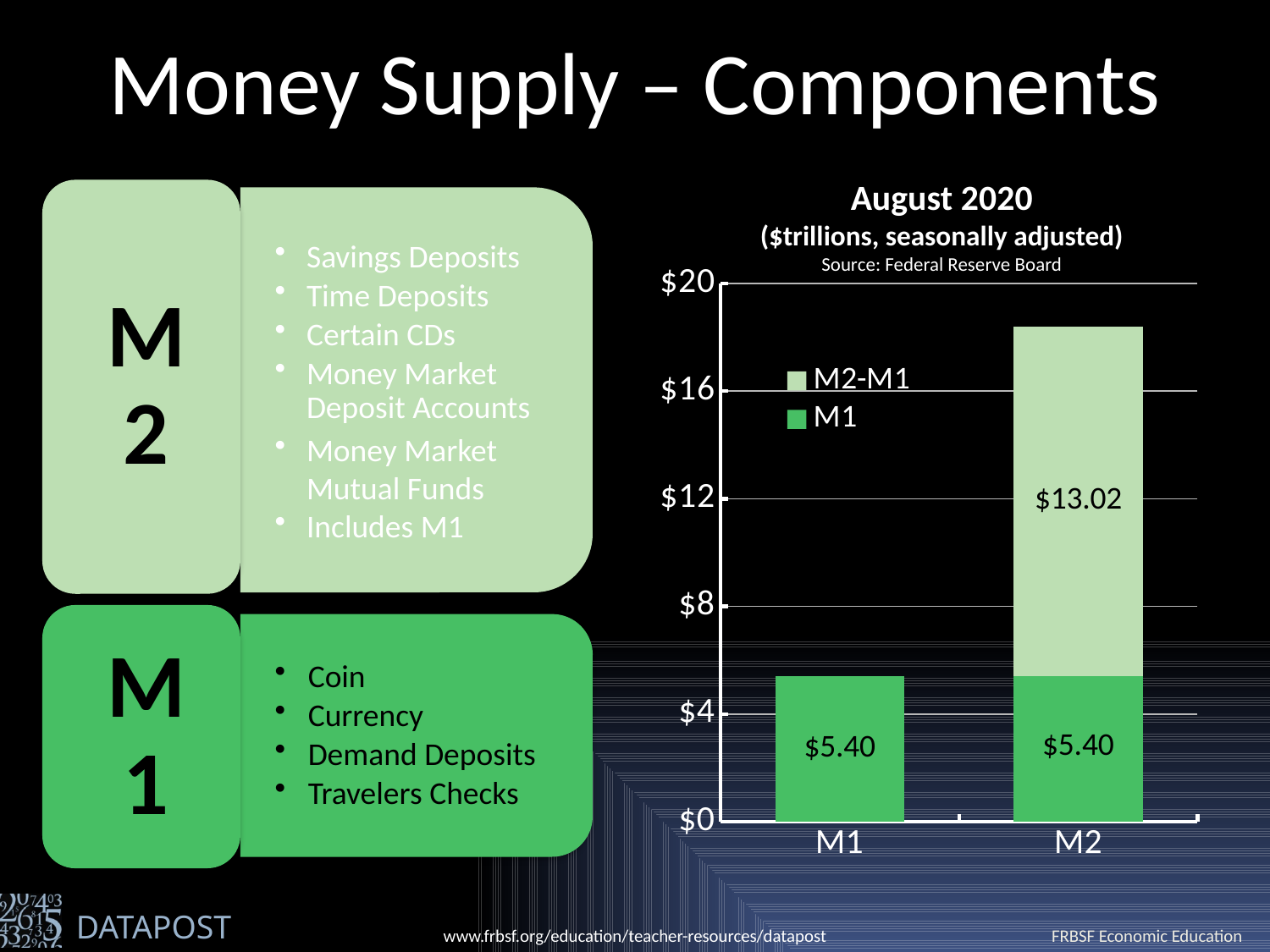
Is the total height of the M2 bar greater or less than $16? greater How many series does the legend list? 2 Is the value of the M1 bar greater or less than $8? less Which bar is taller, M1 or M2? M2 What kind of chart is shown on the slide? Stacked bar chart What month and year does the chart title say the data is for? August 2020 What is the value of the M1 series for the M1 bar? $5.40 How many categories are shown on the x axis? 2 What is the total of the stacked M2 bar? $18.42 What is the difference between the M2-M1 segment and the M1 segment in the M2 bar? $7.62 What is the value of the M2-M1 segment in the M2 bar? $13.02 What is the value of the M1 segment in the M2 bar? $5.40